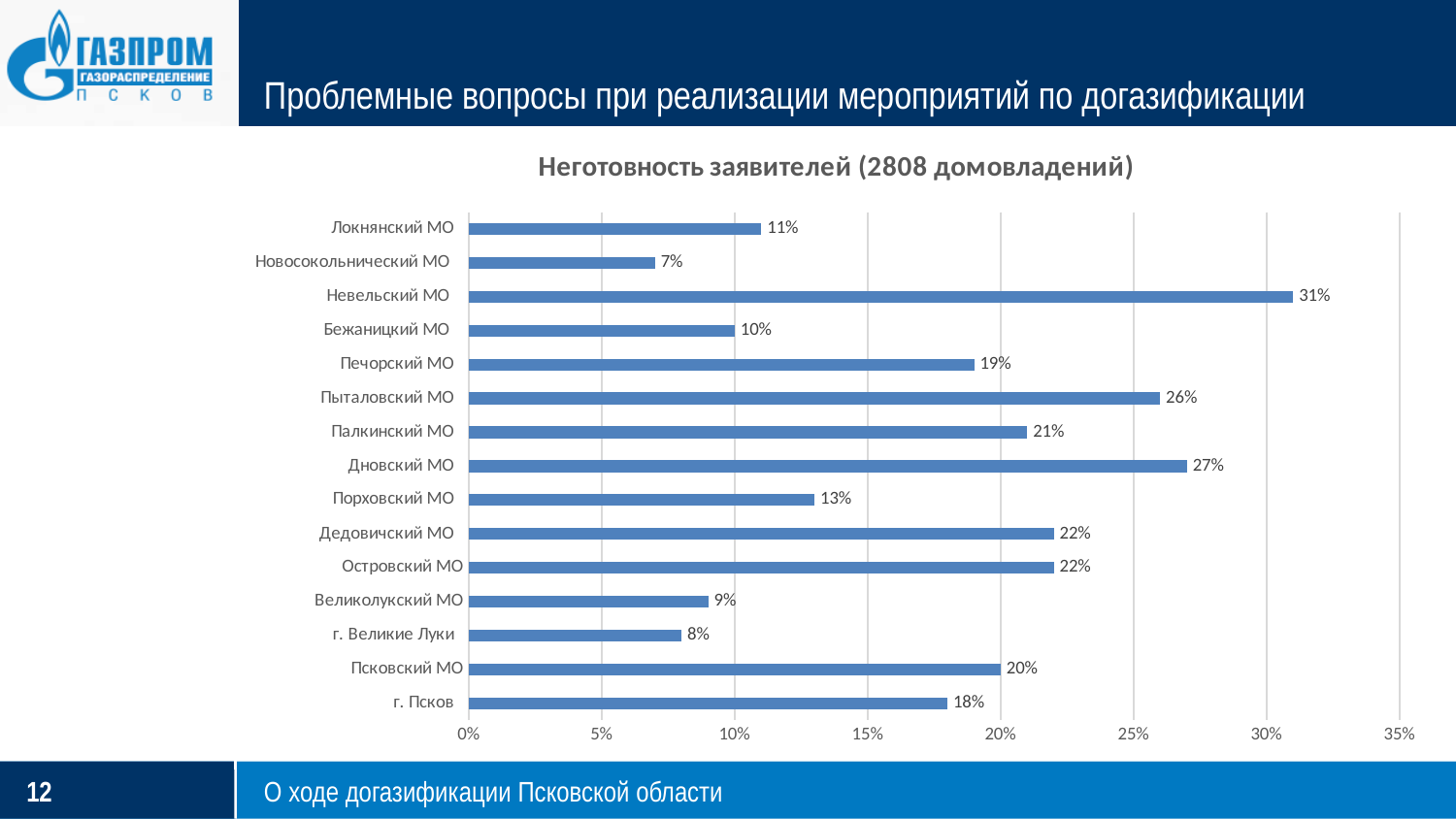
Which category has the highest value? Невельский МО What is the value for Пыталовский МО? 26% How many categories are shown in the chart? 15 What is the difference between the values for Дновский МО and Порховский МО? 14% Which category has the lowest value? Новосокольнический МО What is the difference between the values for Псковский МО and г. Великие Луки? 12% What is the value for Великолукский МО? 9% Which is larger, the value for Печорский МО or the value for Палкинский МО? Палкинский МО What is the value for Невельский МО? 31% What is the title of the chart? Неготовность заявителей (2808 домовладений) What is the value for г. Псков? 18% What kind of chart is shown on the slide? Bar chart